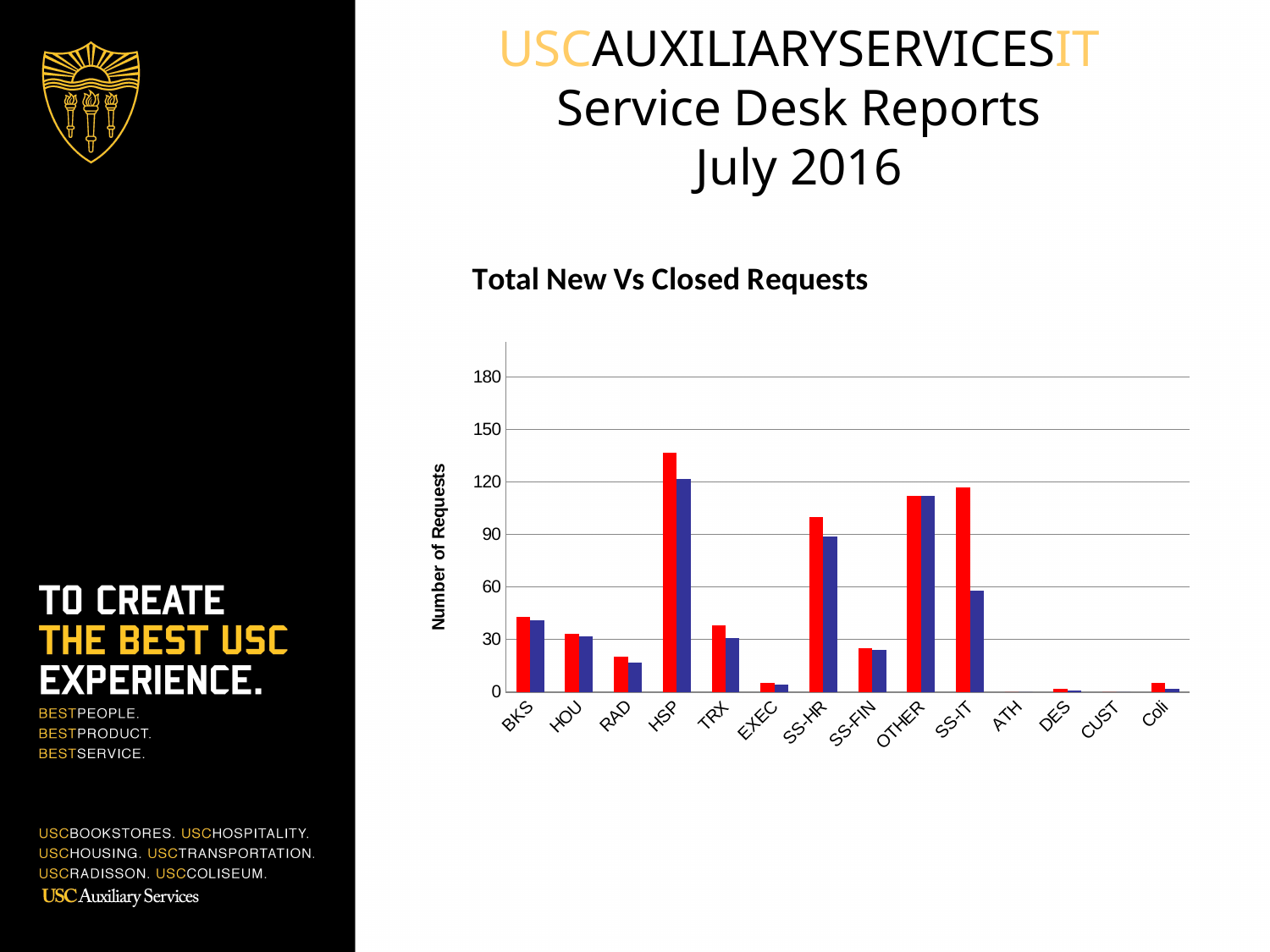
What kind of chart is shown on the slide? bar chart For SS-IT, which bar is taller, the red one or the blue one? the red one Is the red bar for RAD greater or less than 30? less Which has the taller red bar, HSP or SS-HR? HSP Is the red bar for HSP greater or less than 120? greater Is the red bar for OTHER greater or less than 90? greater What is the title of the chart? Total New Vs Closed Requests What is the label on the vertical axis of the chart? Number of Requests Which category has the tallest bar in the chart? HSP How many categories are shown on the x axis of the chart? 14